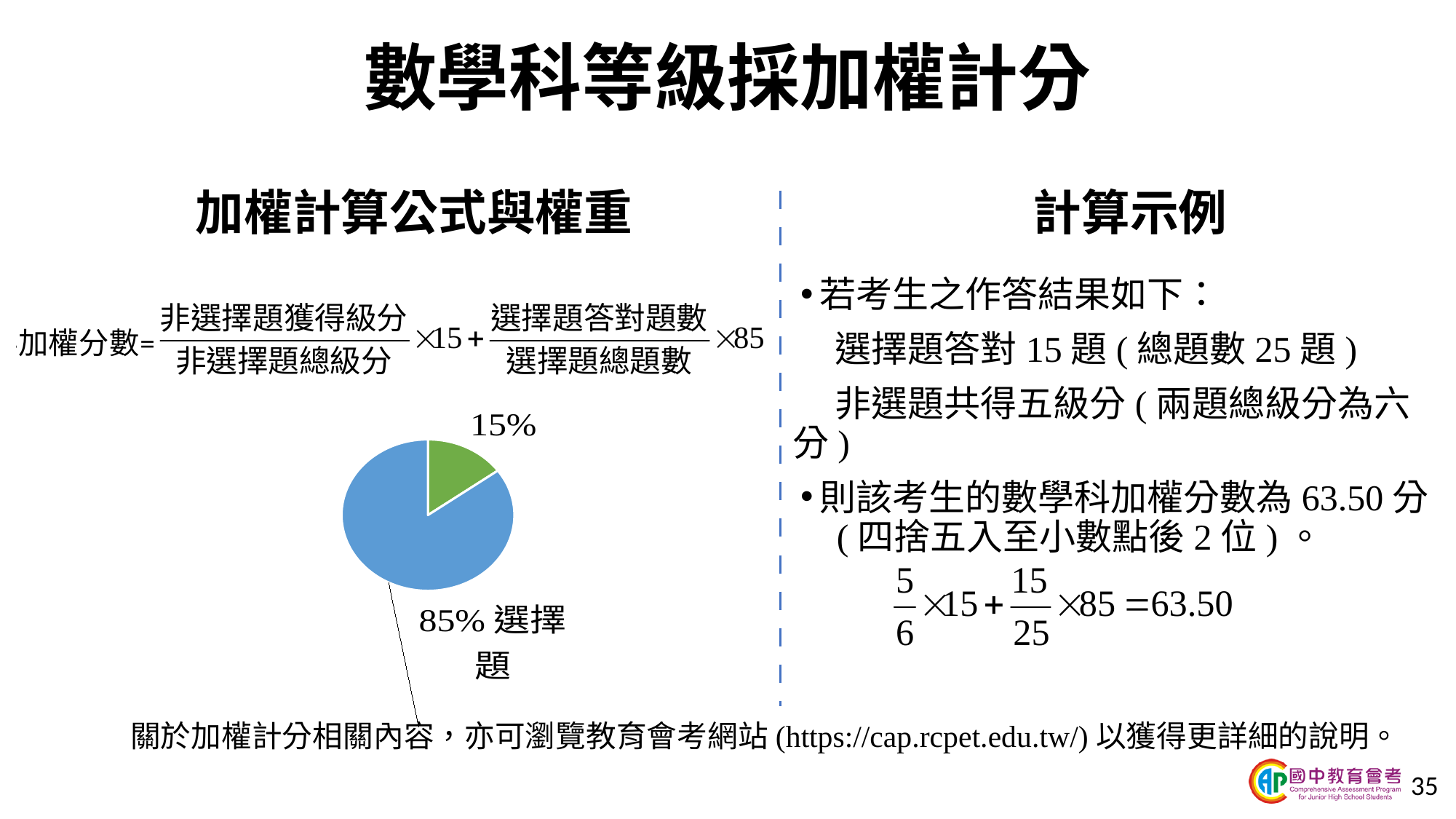
What is the difference in percentage points between the 85% slice and the 15% slice? 70 What colour is the 選擇題 slice of the pie chart? blue What colour is the 15% slice of the pie chart? green What kind of chart is shown on the slide? pie chart What percentage is shown on the smaller (green) slice of the pie chart? 15% Is the share for 選擇題 greater or less than 50%? greater Which slice of the pie chart is the largest? 選擇題 (85%) How many slices does the pie chart have? 2 What is the total of the two percentages shown on the pie chart? 100% Which slice of the pie chart is the smallest? the 15% slice Is the 選擇題 slice larger or smaller than the 15% slice? larger What share of the pie chart is labelled 選擇題? 85%